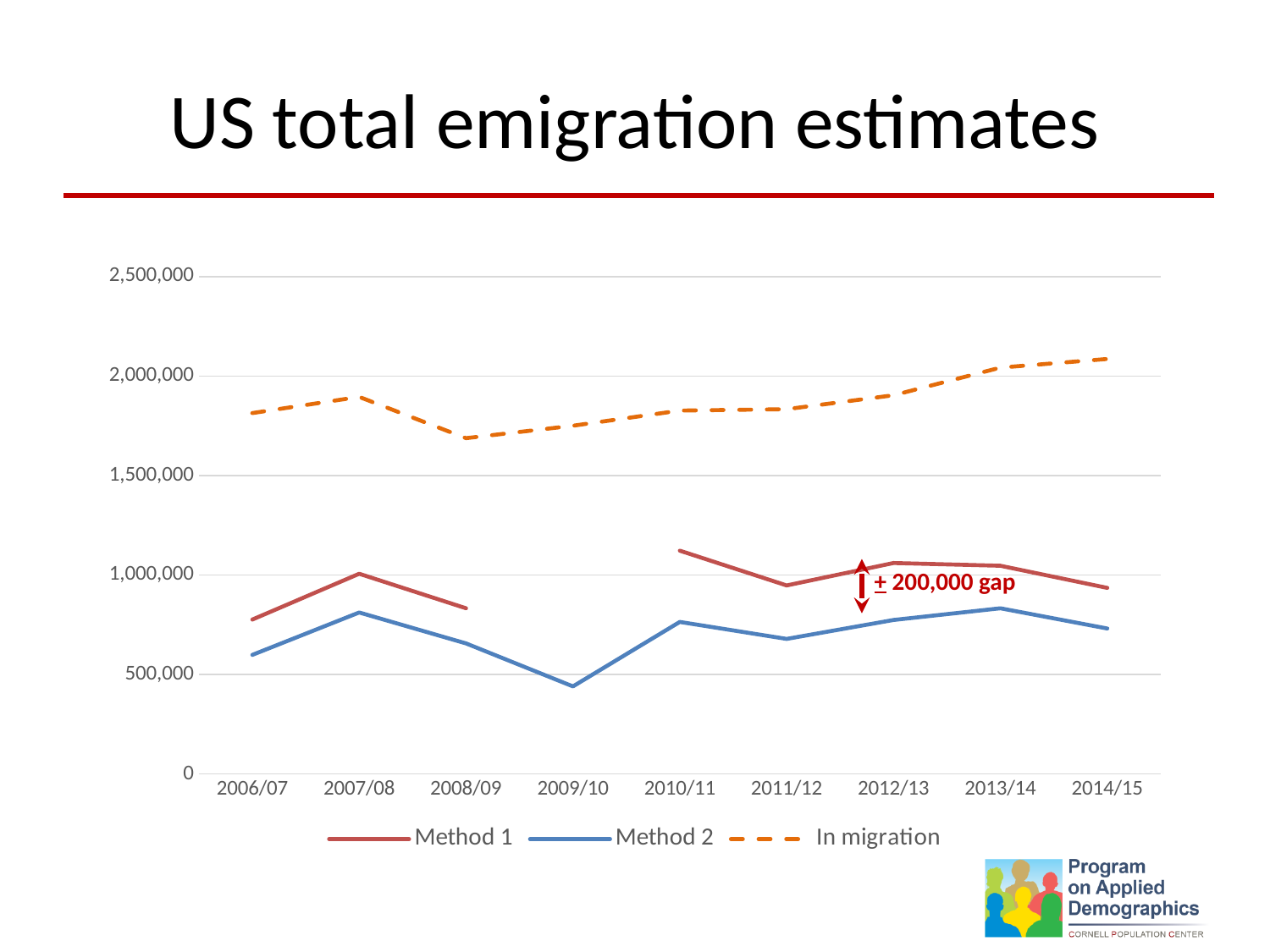
How many series does the legend list? 3 Is the value for In migration in 2014/15 greater or less than 2,000,000? greater What kind of chart is shown on the slide? line chart How many year categories are shown on the x axis? 9 Is the value for In migration in 2008/09 greater or less than 2,000,000? less In which year is the In migration series highest? 2014/15 What is the title of the chart? US total emigration estimates In 2012/13, which is larger, Method 1 or Method 2? Method 1 In which year is the Method 2 series lowest? 2009/10 Which series is drawn with a dashed line? In migration Is the value for Method 1 in 2010/11 greater or less than 1,000,000? greater